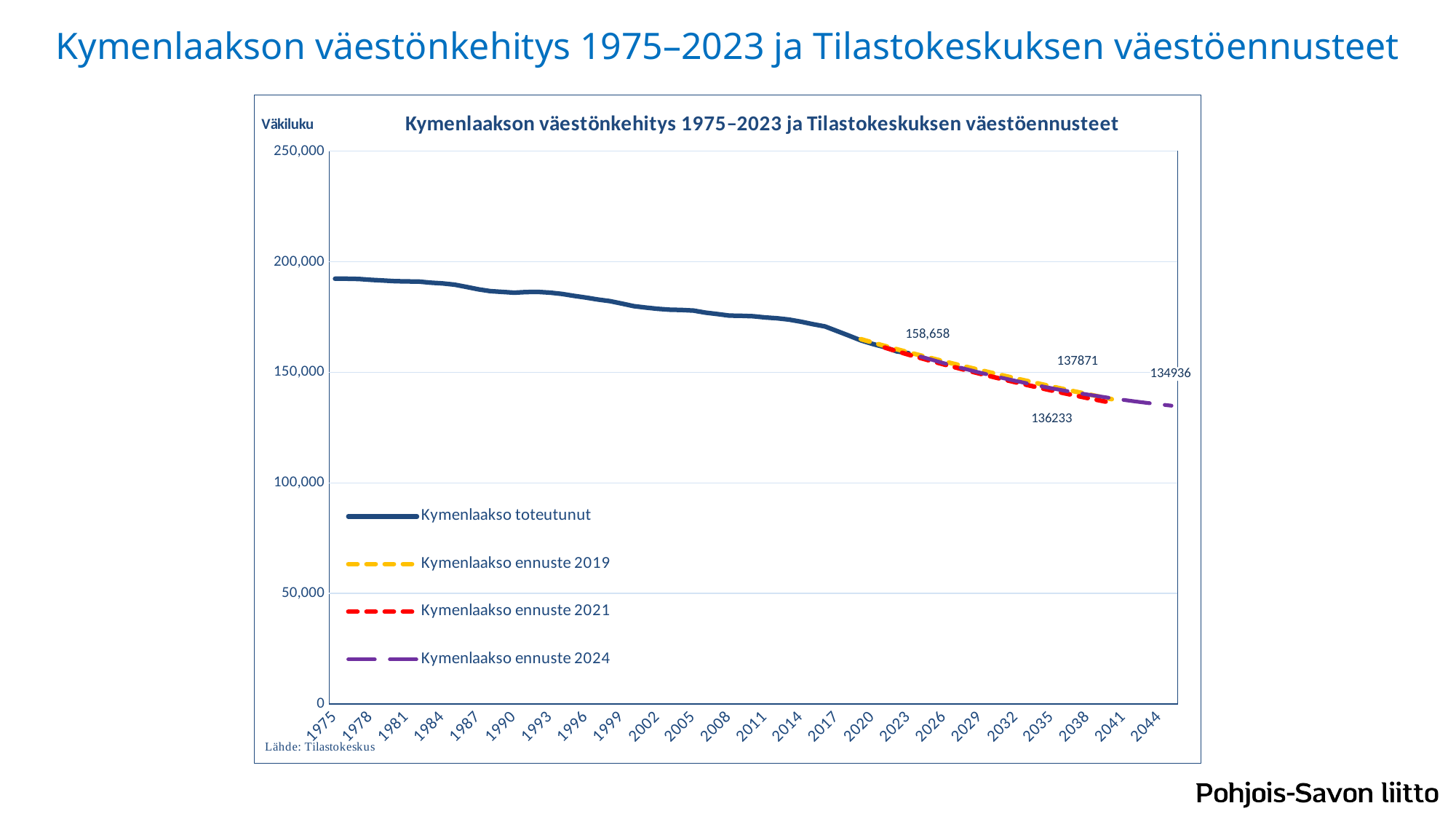
What is the difference between the labelled end values of Kymenlaakso ennuste 2019 (137871) and Kymenlaakso ennuste 2021 (136233)? 1638 What value is labelled near the end of the Kymenlaakso toteutunut line? 158,658 What value is labelled at the end of the Kymenlaakso ennuste 2024 line? 134936 What label is shown on the vertical axis of the chart? Väkiluku What value is labelled at the end of the Kymenlaakso ennuste 2019 line? 137871 Does the Kymenlaakso toteutunut line rise or fall from 1975 to 2023? fall How many series does the chart legend list? 4 What value is labelled at the end of the Kymenlaakso ennuste 2021 line? 136233 What is the title of the chart? Kymenlaakson väestönkehitys 1975–2023 ja Tilastokeskuksen väestöennusteet What kind of chart is shown on the slide? line chart Is the value of the Kymenlaakso toteutunut line in 1975 greater or less than 200,000? less Which forecast ends at a higher labelled value, Kymenlaakso ennuste 2019 or Kymenlaakso ennuste 2021? Kymenlaakso ennuste 2019